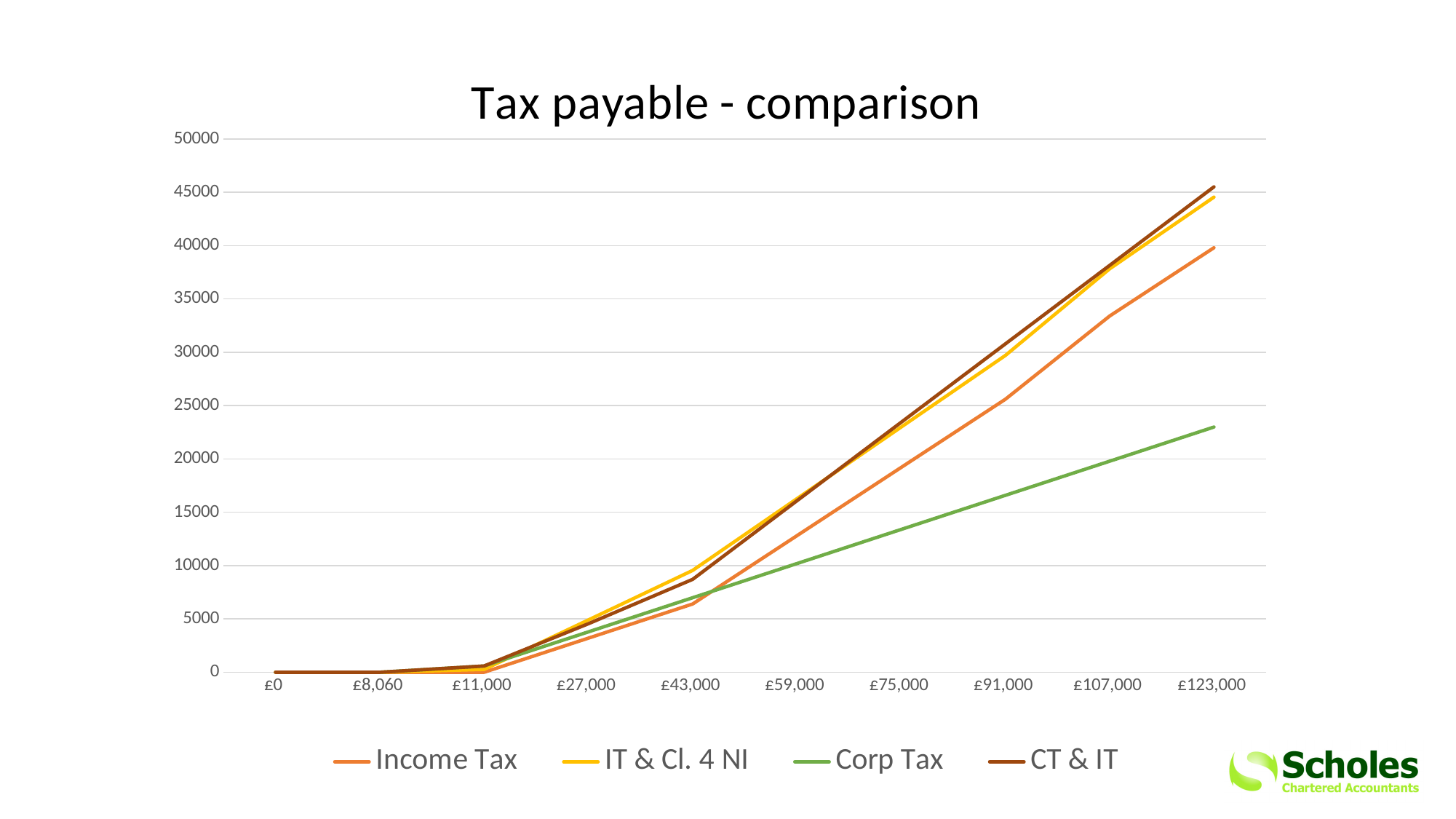
What is the value for Income Tax at £0? 0 How many series does the legend list? 4 What is the title of the chart? Tax payable - comparison Which series has the highest value at £123,000? CT & IT Is the value for Income Tax at £123,000 greater or less than 35000? greater Is the value for Corp Tax at £123,000 greater or less than 25000? less Is the value for Corp Tax at £123,000 greater or less than 20000? greater At £43,000, which is larger: IT & Cl. 4 NI or Corp Tax? IT & Cl. 4 NI How many categories are shown on the x axis? 10 Do the values for CT & IT rise or fall as income increases along the x axis? Rise Which series has the lowest value at £123,000? Corp Tax What kind of chart is shown on the slide? Line chart